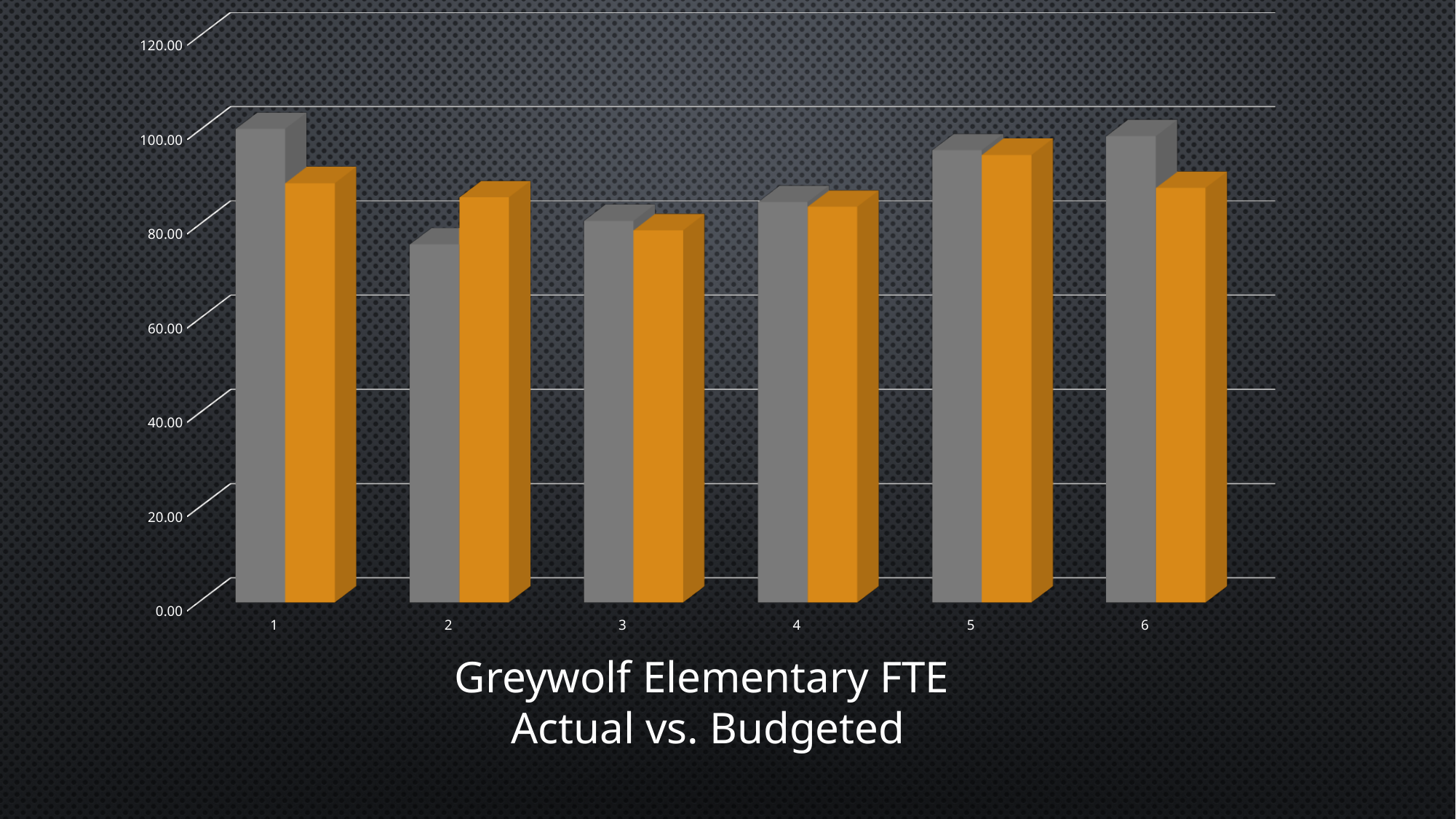
Which category has the lowest grey bar? 2 In category 1, which bar is taller, the grey bar or the orange bar? Grey bar What two colours are used for the bars in the chart? Grey and orange What type of chart is shown on the slide? Bar chart What is the title of the chart? Greywolf Elementary FTE Actual vs. Budgeted How many categories are shown along the x axis of the chart? 6 Is the orange bar for category 2 greater or less than 80.00? greater Is the grey bar for category 2 greater or less than 80.00? less In category 2, which bar is taller, the grey bar or the orange bar? Orange bar Is the orange bar for category 5 greater or less than 100.00? less Which category has the highest orange bar? 5 Which category has the lowest orange bar? 3